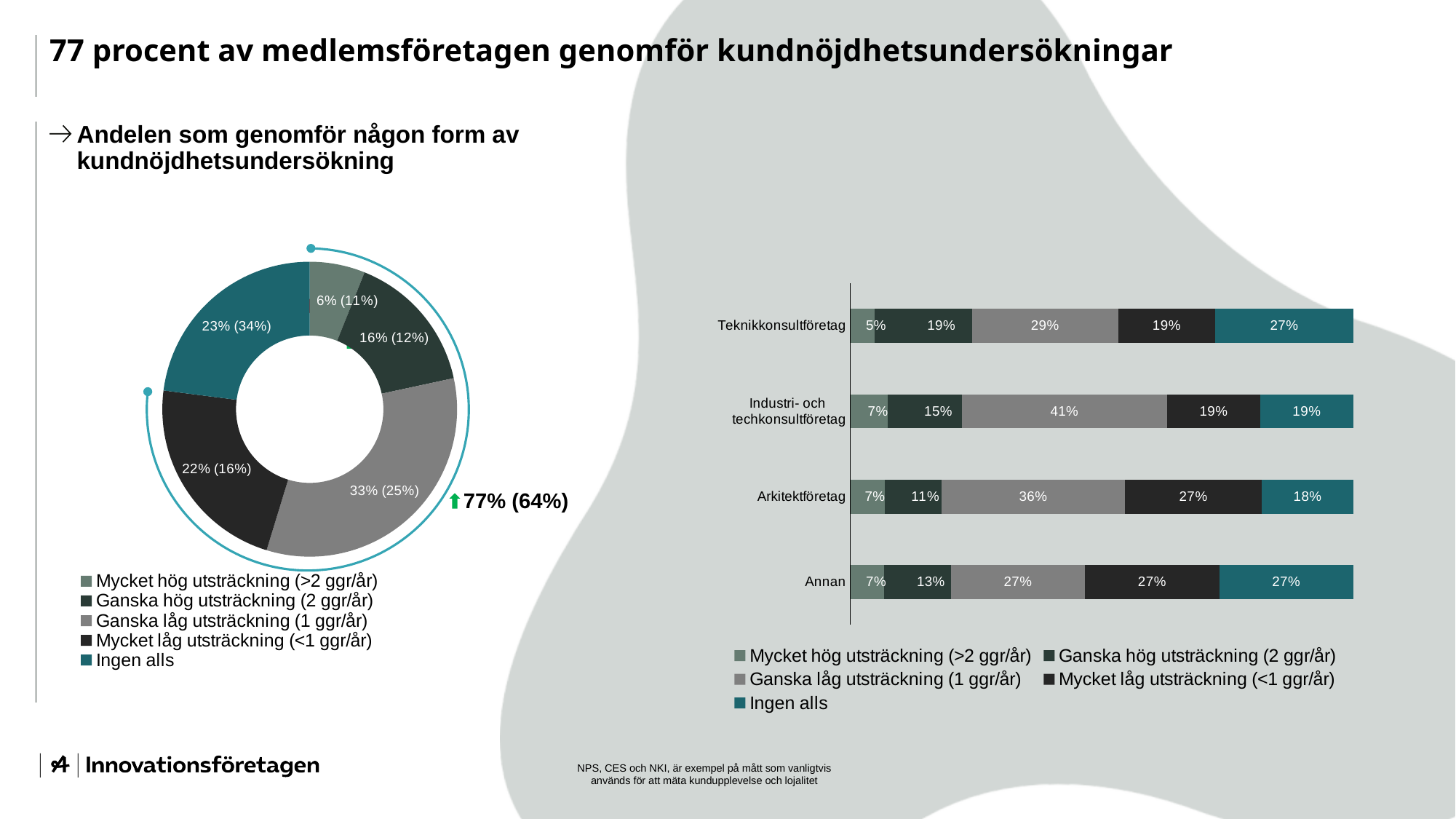
In the stacked bar chart on the right, how many categories (bars) are shown? 4 In the donut chart on the left, how many categories does the legend list? 5 What type of chart is shown on the left side of the slide? Donut (pie) chart In the stacked bar chart on the right, how many series does the legend list? 5 In the stacked bar chart on the right, which is larger: the 'Mycket låg utsträckning (<1 ggr/år)' value for Arkitektföretag or for Teknikkonsultföretag? Arkitektföretag In the stacked bar chart on the right, what is the difference between the 'Ingen alls' values for Teknikkonsultföretag and Arkitektföretag? 9 percentage points In the stacked bar chart on the right, what is the value for 'Ingen alls' for Arkitektföretag? 18% In the donut chart on the left, what is the value shown for 'Ganska låg utsträckning (1 ggr/år)'? 33% (25%) In the stacked bar chart on the right, what is the value for 'Ganska låg utsträckning (1 ggr/år)' for Industri- och techkonsultföretag? 41% In the donut chart on the left, which category has the smallest slice? Mycket hög utsträckning (>2 ggr/år) In the donut chart on the left, which category has the largest slice? Ganska låg utsträckning (1 ggr/år) In the stacked bar chart on the right, which category has the highest value for 'Ganska låg utsträckning (1 ggr/år)'? Industri- och techkonsultföretag